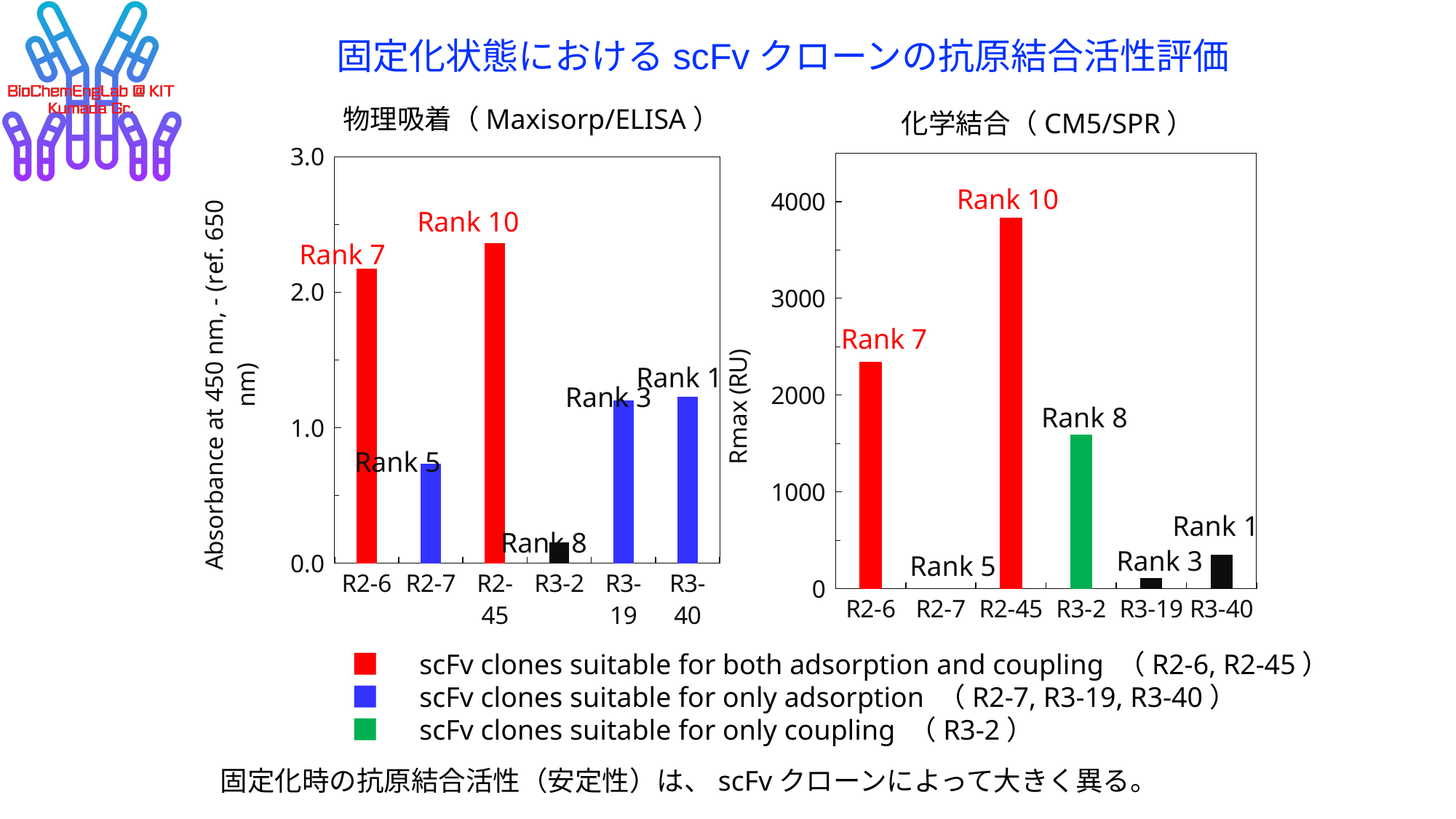
In the right chart (化学結合 CM5/SPR), what rank label is printed above the R2-45 bar? Rank 10 In the left chart (物理吸着 Maxisorp/ELISA), is the value for R2-7 greater or less than 1.0? less According to the legend, what do the green bars represent? scFv clones suitable for only coupling (R3-2) In the left chart (物理吸着 Maxisorp/ELISA), which has the larger absorbance, R2-6 or R3-19? R2-6 In the left chart (物理吸着 Maxisorp/ELISA), is the value for R2-6 greater or less than 2.0? greater In the left chart (物理吸着 Maxisorp/ELISA), which clone has the highest absorbance? R2-45 In the left chart (物理吸着 Maxisorp/ELISA), which clone has the lowest absorbance? R3-2 In the right chart (化学結合 CM5/SPR), which clone has the highest Rmax? R2-45 In the left chart (物理吸着 Maxisorp/ELISA), what kind of chart is shown? bar chart In the left chart (物理吸着 Maxisorp/ELISA), how many clones are plotted on the x axis? 6 In the right chart (化学結合 CM5/SPR), which has the larger Rmax, R3-2 or R3-40? R3-2 In the right chart (化学結合 CM5/SPR), is the value for R2-45 greater or less than 3000? greater